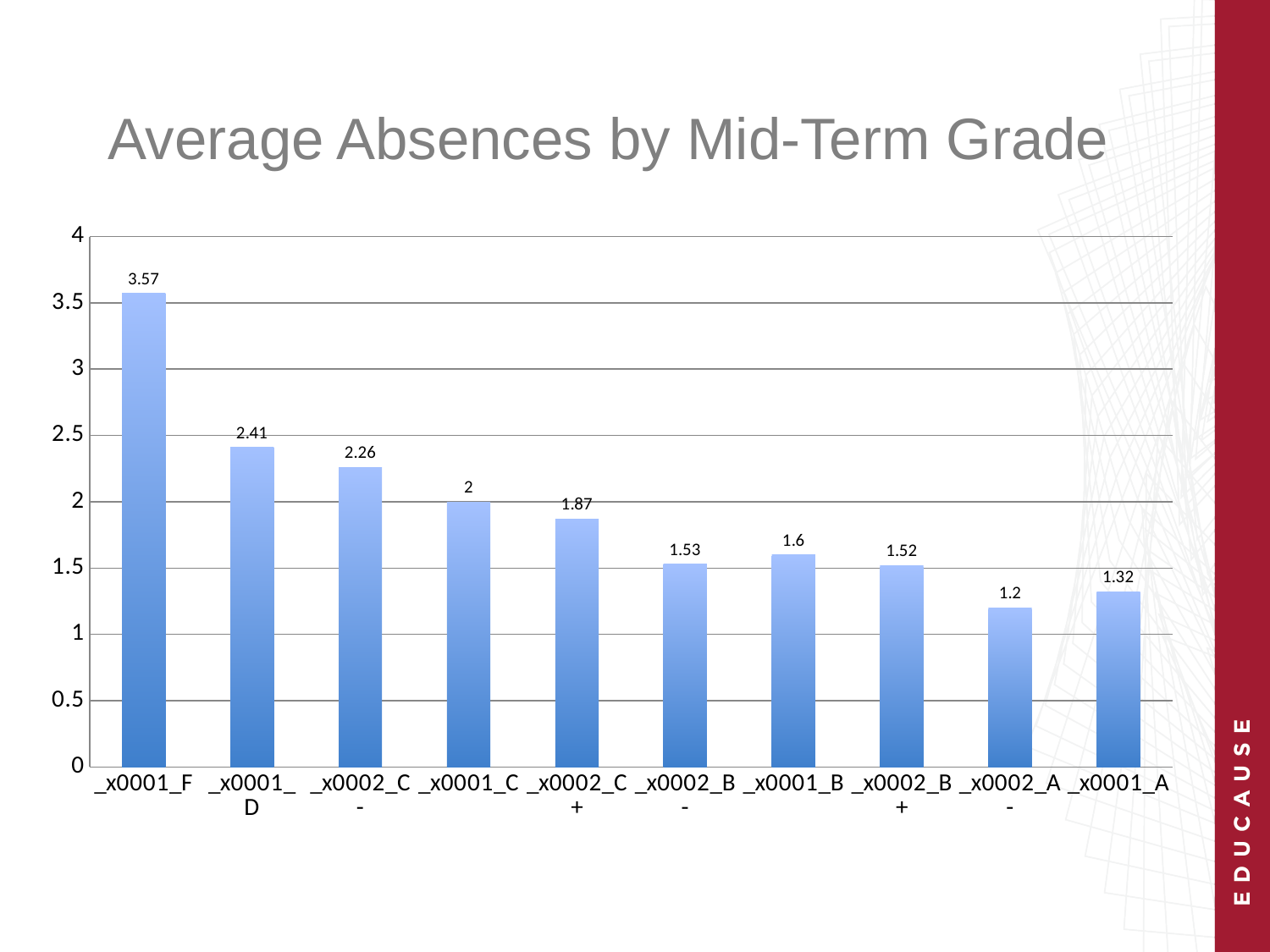
How many categories are shown on the x axis? 10 What kind of chart is shown on the slide? Bar chart What is the value shown for the category labelled _x0002_A-? 1.2 Which has the larger value, _x0001_B or _x0002_B-? _x0001_B What is the value shown for the category labelled _x0001_C? 2 What is the average absences value for the category labelled _x0001_F? 3.57 What is the difference between the values for _x0002_C- and _x0002_C+? 0.39 What is the title of the chart? Average Absences by Mid-Term Grade Is the value for _x0001_D greater or less than 2.5? less What is the difference between the values for _x0001_F and _x0001_D? 1.16 Which category has the highest average absences? _x0001_F Which category has the lowest average absences? _x0002_A-